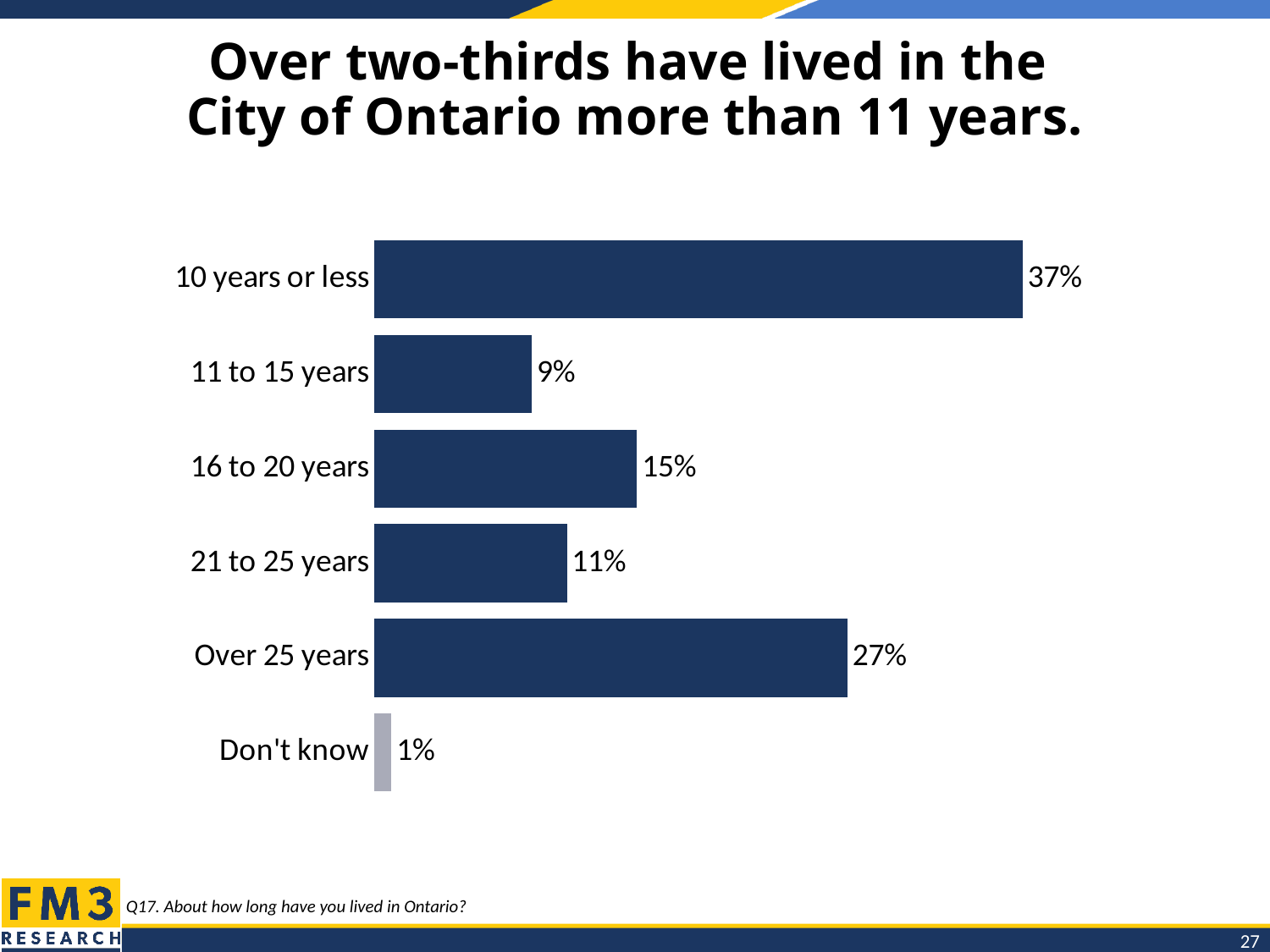
How many categories are shown in the chart? 6 Which category has the highest value? 10 years or less What is the survey question referenced at the bottom of the slide? Q17. About how long have you lived in Ontario? What kind of chart is shown on the slide? Bar chart What is the value for the "Over 25 years" category? 27% What is the difference between the values for "10 years or less" and "Over 25 years"? 10% Which category has the lowest value? Don't know What percentage of respondents have lived in Ontario for 16 to 20 years? 15% What is the difference between the values for "16 to 20 years" and "11 to 15 years"? 6% What is the value shown for "Don't know"? 1% Which is larger, the value for "21 to 25 years" or the value for "11 to 15 years"? 21 to 25 years What percentage of respondents have lived in Ontario for 10 years or less? 37%